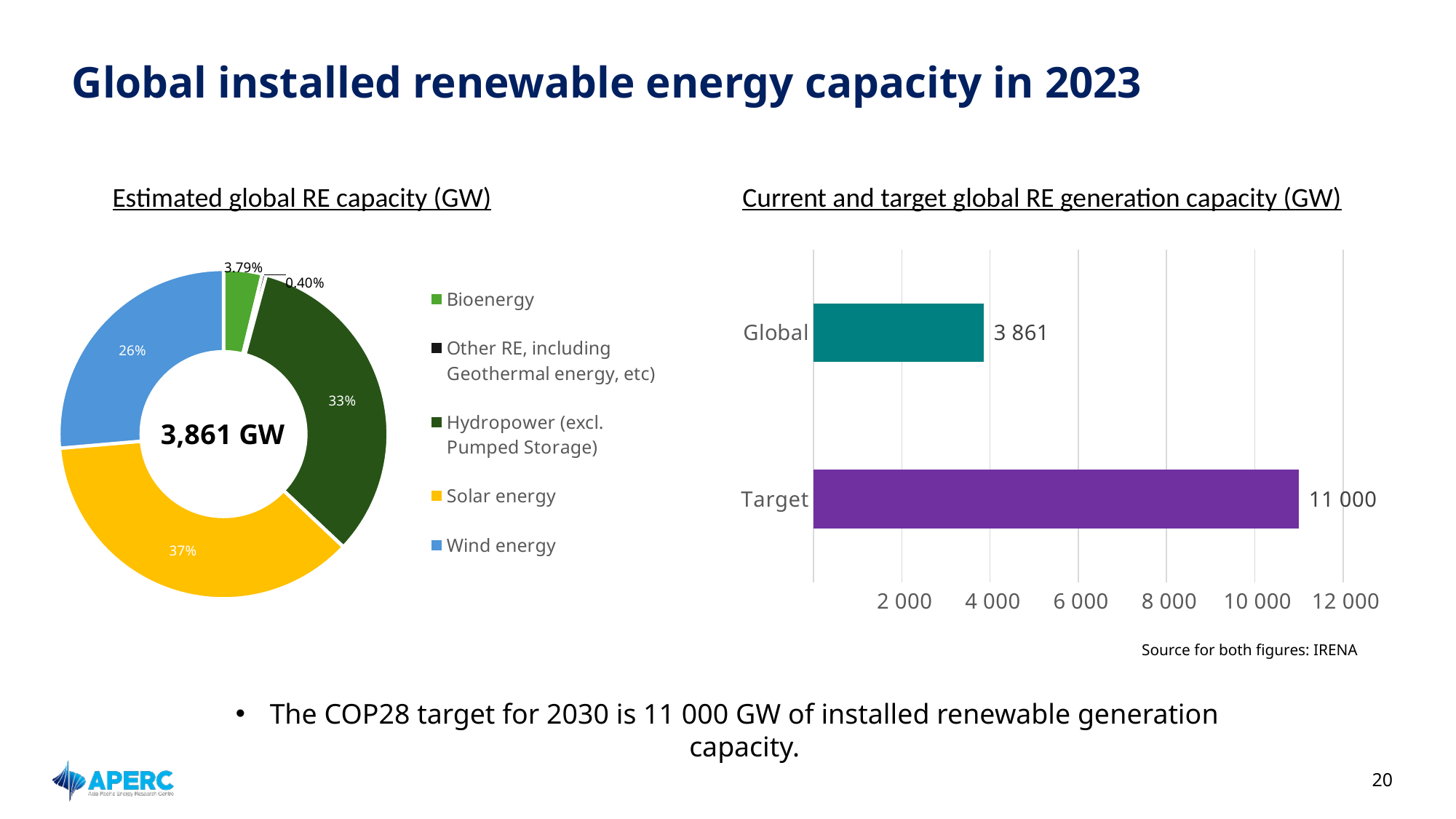
What total value is shown in the centre of the 'Estimated global RE capacity (GW)' chart? 3,861 GW In the 'Estimated global RE capacity (GW)' chart, what share does Wind energy have? 26% In the 'Estimated global RE capacity (GW)' chart, what share does Other RE, including Geothermal energy, etc) have? 0.40% In the 'Estimated global RE capacity (GW)' chart, how many categories does the legend list? 5 In the 'Estimated global RE capacity (GW)' chart, which category has the smallest share? Other RE, including Geothermal energy, etc) In the 'Estimated global RE capacity (GW)' chart, what share does Solar energy have? 37% In the 'Current and target global RE generation capacity (GW)' chart, what is the difference between the Target and Global values? 7 139 In the 'Estimated global RE capacity (GW)' chart, which category has the largest share? Solar energy In the 'Current and target global RE generation capacity (GW)' chart, what is the value for Global? 3 861 In the 'Current and target global RE generation capacity (GW)' chart, what is the value for Target? 11 000 What kind of chart is the 'Current and target global RE generation capacity (GW)' chart? Bar chart